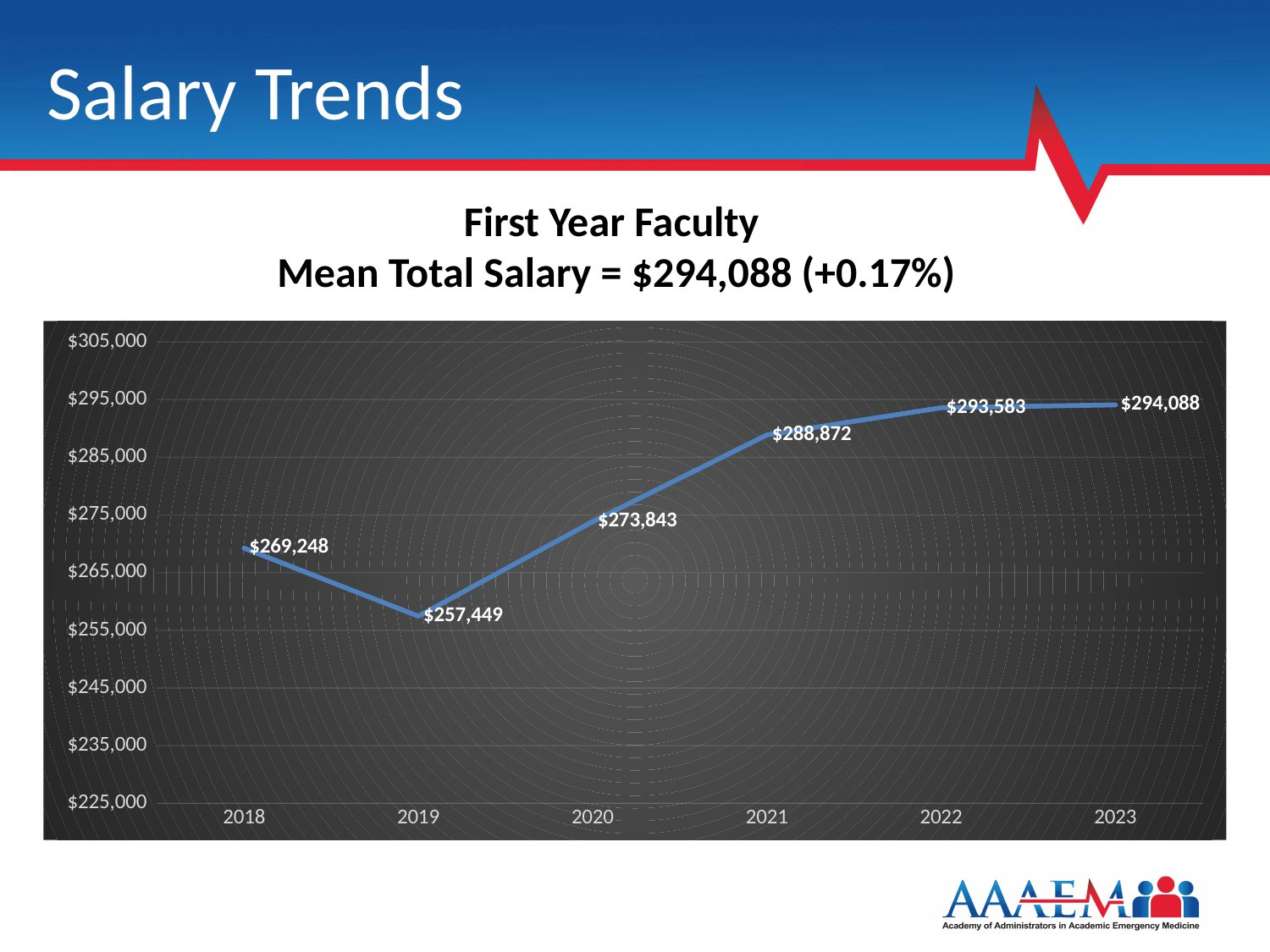
Which year has the lowest mean total salary on the chart? 2019 What is the difference between the 2020 and 2019 mean total salaries? $16,394 Does the mean total salary rise or fall from 2019 to 2023? Rise What kind of chart is shown on the slide? Line chart Is the mean total salary for 2021 greater or less than $285,000? greater What is the mean total salary for first year faculty in 2019? $257,449 Which year has a higher mean total salary, 2018 or 2020? 2020 How many years are plotted on the chart? 6 Which year has the highest mean total salary on the chart? 2023 What is the mean total salary for first year faculty in 2018? $269,248 What is the difference between the 2023 and 2022 mean total salaries? $505 What is the mean total salary for first year faculty in 2021? $288,872